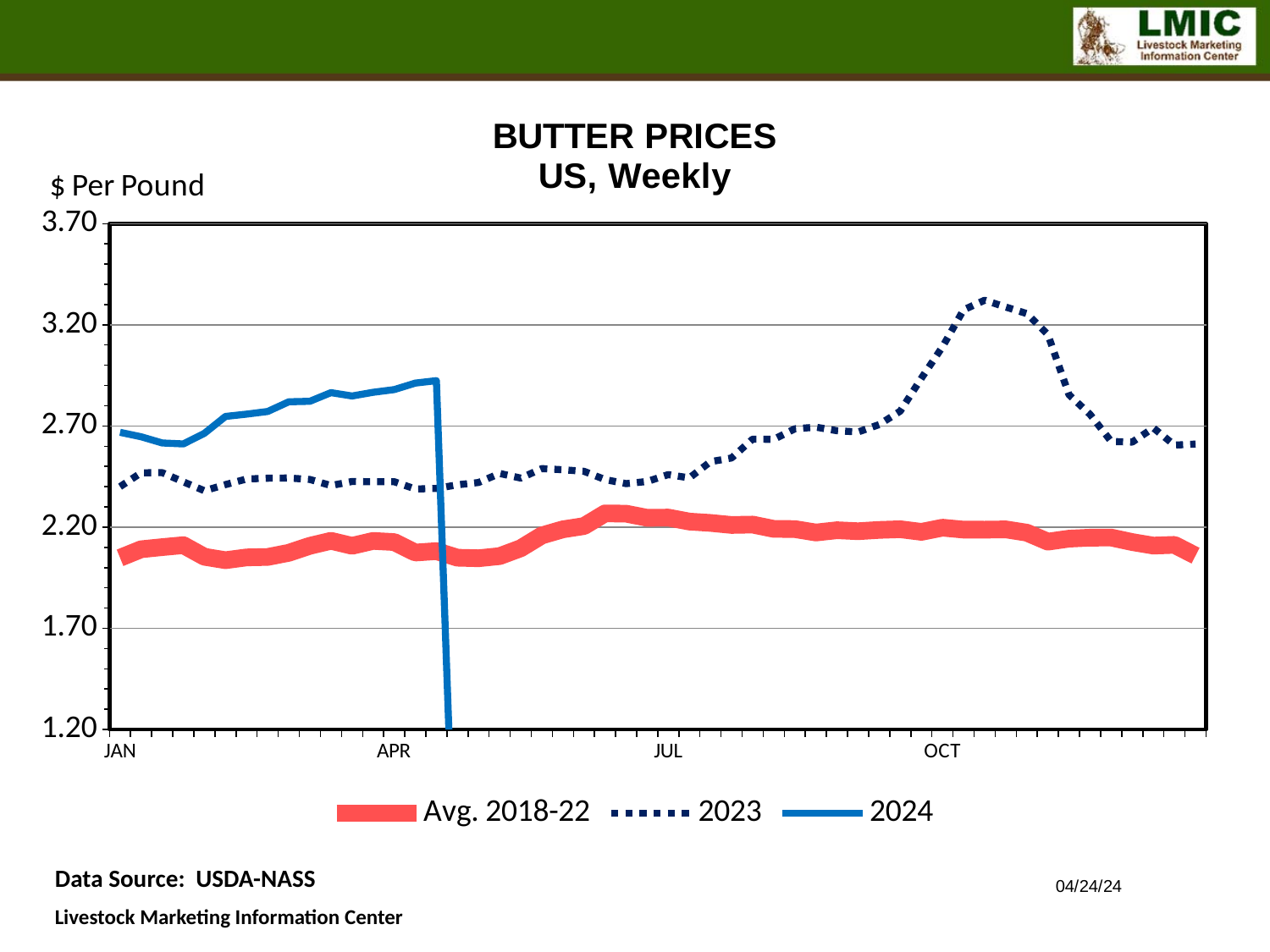
Which series has the lowest value in JAN? Avg. 2018-22 In JAN, which is higher: the 2024 line or the 2023 line? 2024 What unit is shown on the y-axis label? $ Per Pound Is the 2024 value in APR greater or less than 2.70? greater Is the Avg. 2018-22 value in JAN greater or less than 2.20? less Is the 2024 value in JAN greater or less than 2.20? greater What kind of chart is shown on the slide? line chart What is the title of the chart? BUTTER PRICES US, Weekly Does the 2024 line rise or fall from JAN to APR? rise How many series does the legend list? 3 In OCT, which is higher: the 2023 line or the Avg. 2018-22 line? 2023